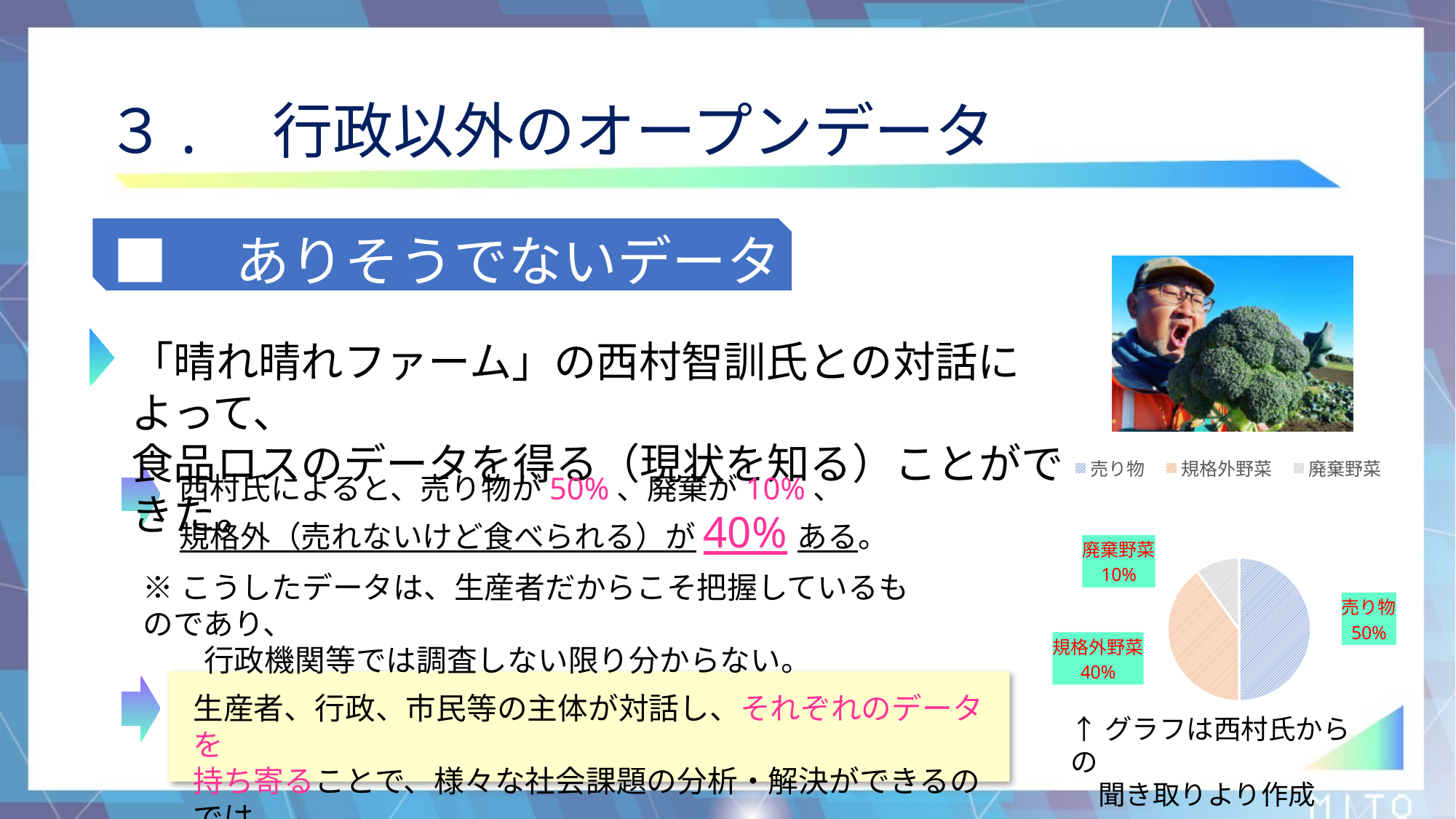
What share of the pie chart is 売り物? 50% How many entries does the legend of the pie chart list? 3 Which is larger in the pie chart, 規格外野菜 or 廃棄野菜? 規格外野菜 What kind of chart is shown on the slide? pie chart Which category has the largest slice in the pie chart? 売り物 What is the difference between the shares of 売り物 and 廃棄野菜? 40% What are the three legend entries of the pie chart? 売り物, 規格外野菜, 廃棄野菜 How many slices does the pie chart have? 3 Which category has the smallest slice in the pie chart? 廃棄野菜 What is the difference between the shares of 規格外野菜 and 廃棄野菜? 30% What share of the pie chart is 廃棄野菜? 10% What share of the pie chart is 規格外野菜? 40%